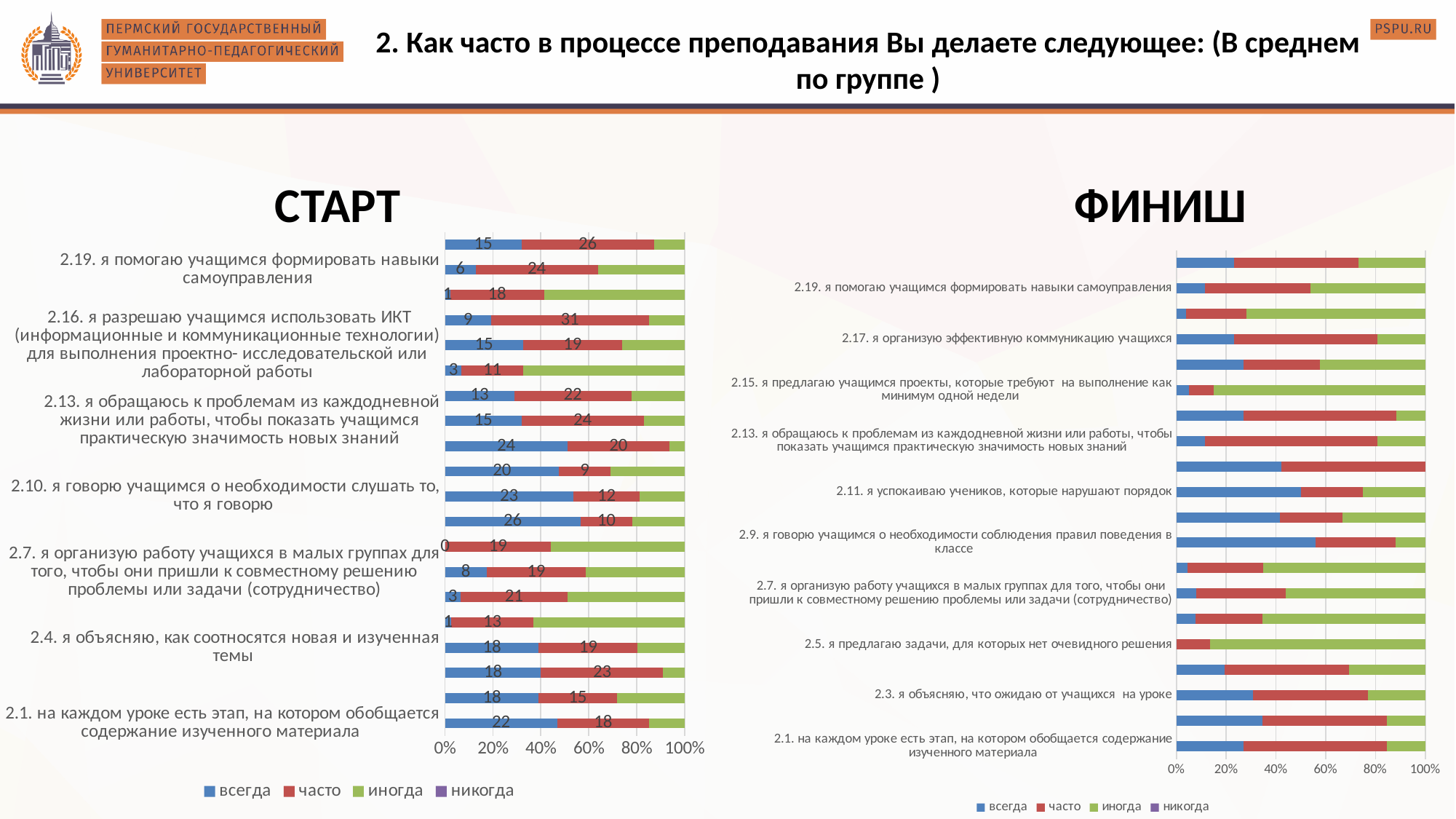
On the СТАРТ chart, what is the value of всегда for category 2.1 (на каждом уроке есть этап, на котором обобщается содержание изученного материала)? 22 On the ФИНИШ chart, is the всегда share for category 2.11 (я успокаиваю учеников, которые нарушают порядок) greater or less than 40%? greater On the СТАРТ chart, what is the value of часто for category 2.13 (я обращаюсь к проблемам из каждодневной жизни или работы)? 24 What kind of chart is the ФИНИШ chart? Bar chart On the СТАРТ chart, what is the value of всегда for category 2.19 (я помогаю учащимся формировать навыки самоуправления)? 6 How many series does the legend of the ФИНИШ chart list? 4 Which legend entry on the СТАРТ chart is shown in blue? всегда On the СТАРТ chart, which has the larger всегда value: category 2.1 or category 2.19? 2.1 On the ФИНИШ chart, is the всегда share for category 2.19 (я помогаю учащимся формировать навыки самоуправления) greater or less than 20%? less On the СТАРТ chart, for category 2.13, what is the difference between the часто value and the всегда value? 9 On the СТАРТ chart, what is the value of часто for category 2.1? 18 On the СТАРТ chart, what is the value of всегда for category 2.10 (я говорю учащимся о необходимости слушать то, что я говорю)? 23